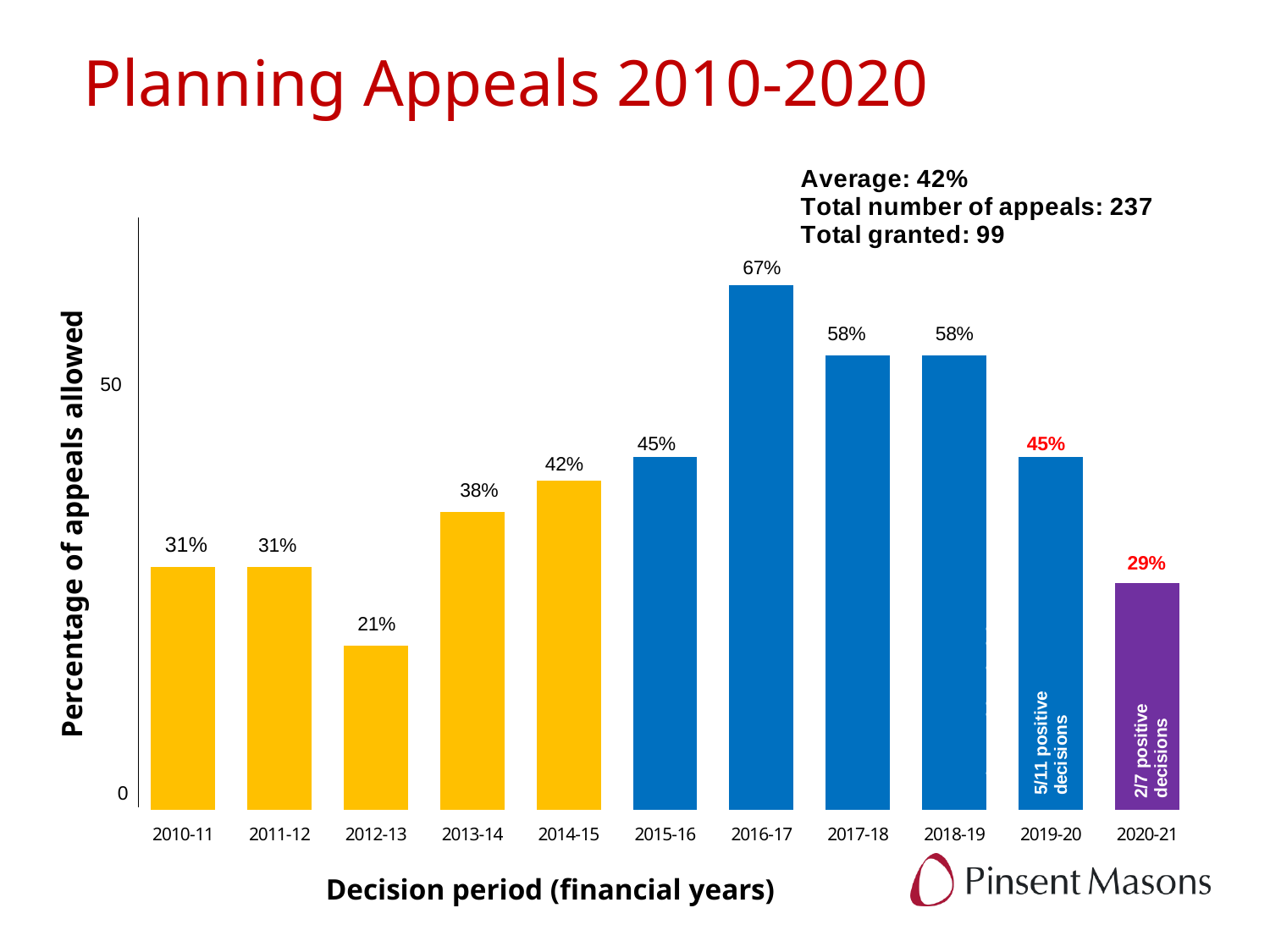
Which decision period has the highest percentage of appeals allowed? 2016-17 What is the difference in percentage points between 2016-17 and 2017-18? 9 What kind of chart is shown on the slide? bar chart Is the value for 2018-19 greater or less than 50? greater Do the values rise or fall from 2012-13 to 2016-17? rise Which decision period has the lowest percentage of appeals allowed? 2012-13 What percentage of appeals was allowed in 2012-13? 21% How many decision periods are shown on the x axis? 11 What percentage of appeals was allowed in 2020-21? 29% Which is larger, the value for 2013-14 or the value for 2014-15? 2014-15 What percentage of appeals was allowed in 2016-17? 67% What is the average percentage of appeals allowed stated on the slide? 42%